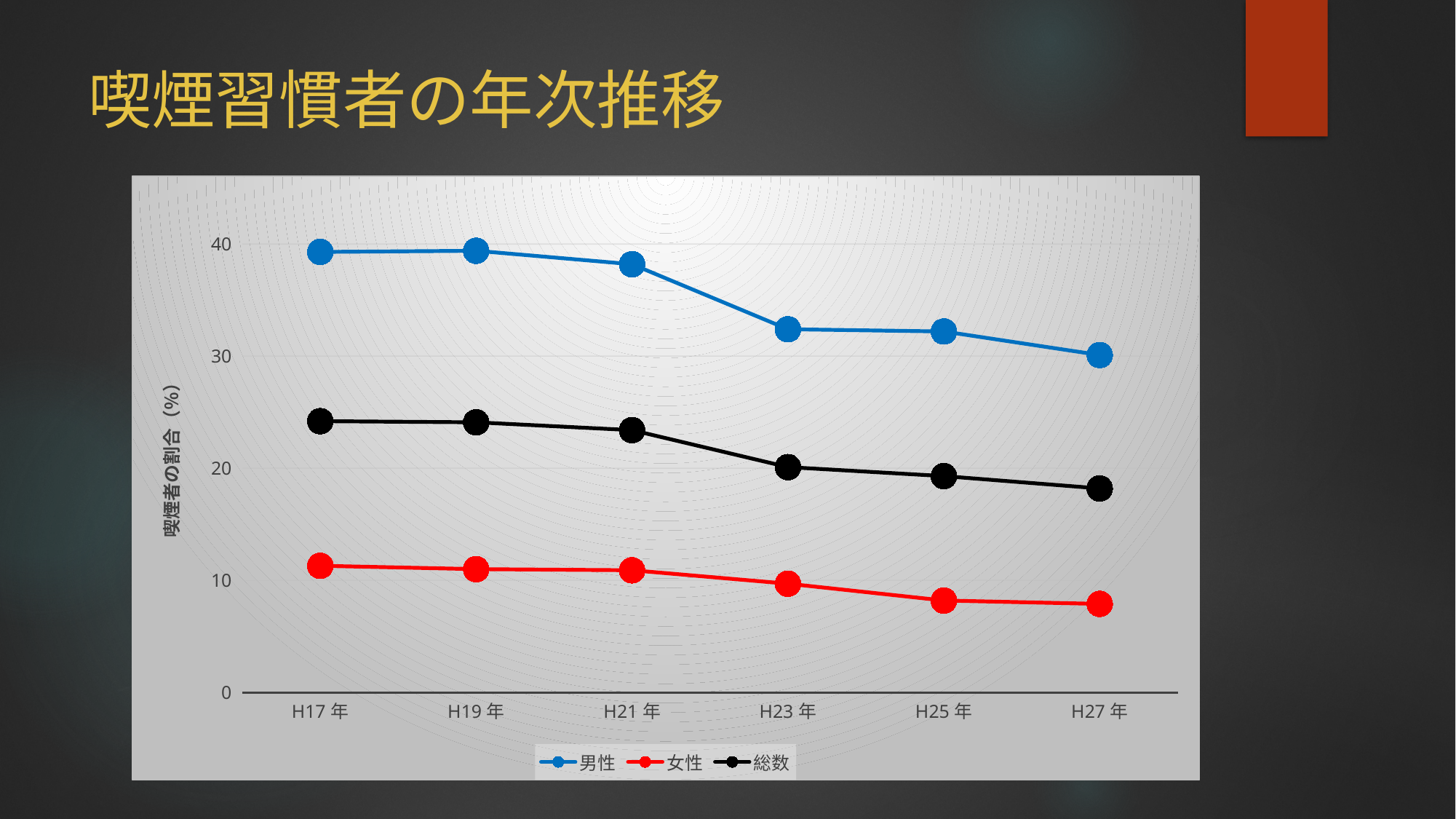
Is the value for 男性 in H27年 greater or less than 40? less Is the value for 男性 in H17年 greater or less than 30? greater Is the value for 総数 in H27年 greater or less than 20? less How many years are plotted along the x axis? 6 In which year is the value for 男性 lowest? H27年 What is the title of the chart on the slide? 喫煙習慣者の年次推移 Which is larger in H21年, the value for 男性 or the value for 女性? 男性 What kind of chart is shown on the slide? line chart Does the value for 総数 rise or fall from H17年 to H27年? fall How many series does the legend list? 3